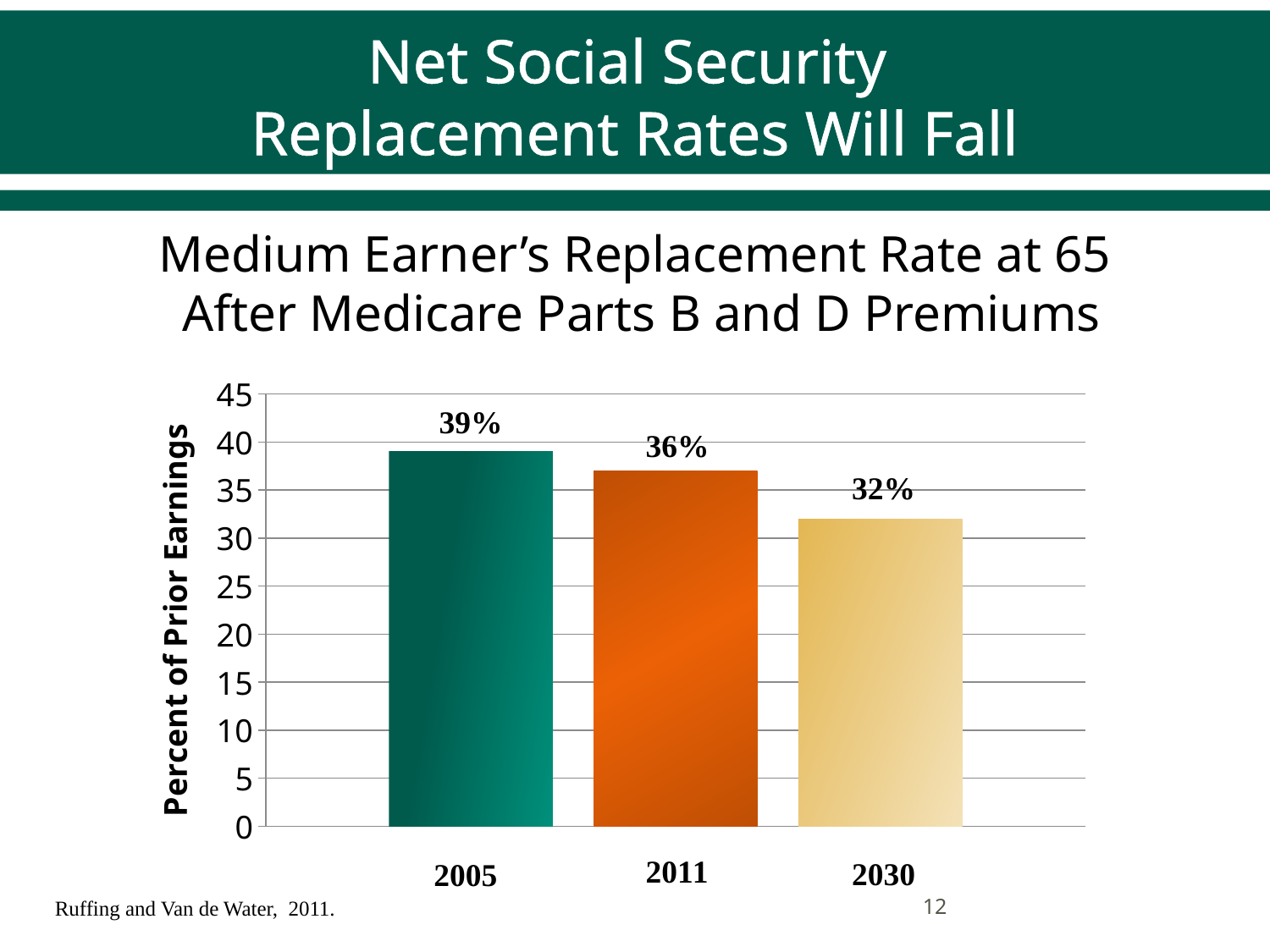
What is the difference between the replacement rates for 2005 and 2030? 7% What is the replacement rate shown for 2005? 39% Which year has the highest replacement rate? 2005 How many years are shown on the chart? 3 What is the difference between the replacement rates for 2011 and 2030? 4% Do the replacement rates rise or fall from 2005 to 2030? fall What kind of chart is shown on the slide? bar chart Which is larger, the replacement rate for 2005 or for 2011? 2005 What is the replacement rate shown for 2030? 32% Which year has the lowest replacement rate? 2030 Is the value for 2030 greater or less than 35? less What is the replacement rate shown for 2011? 36%